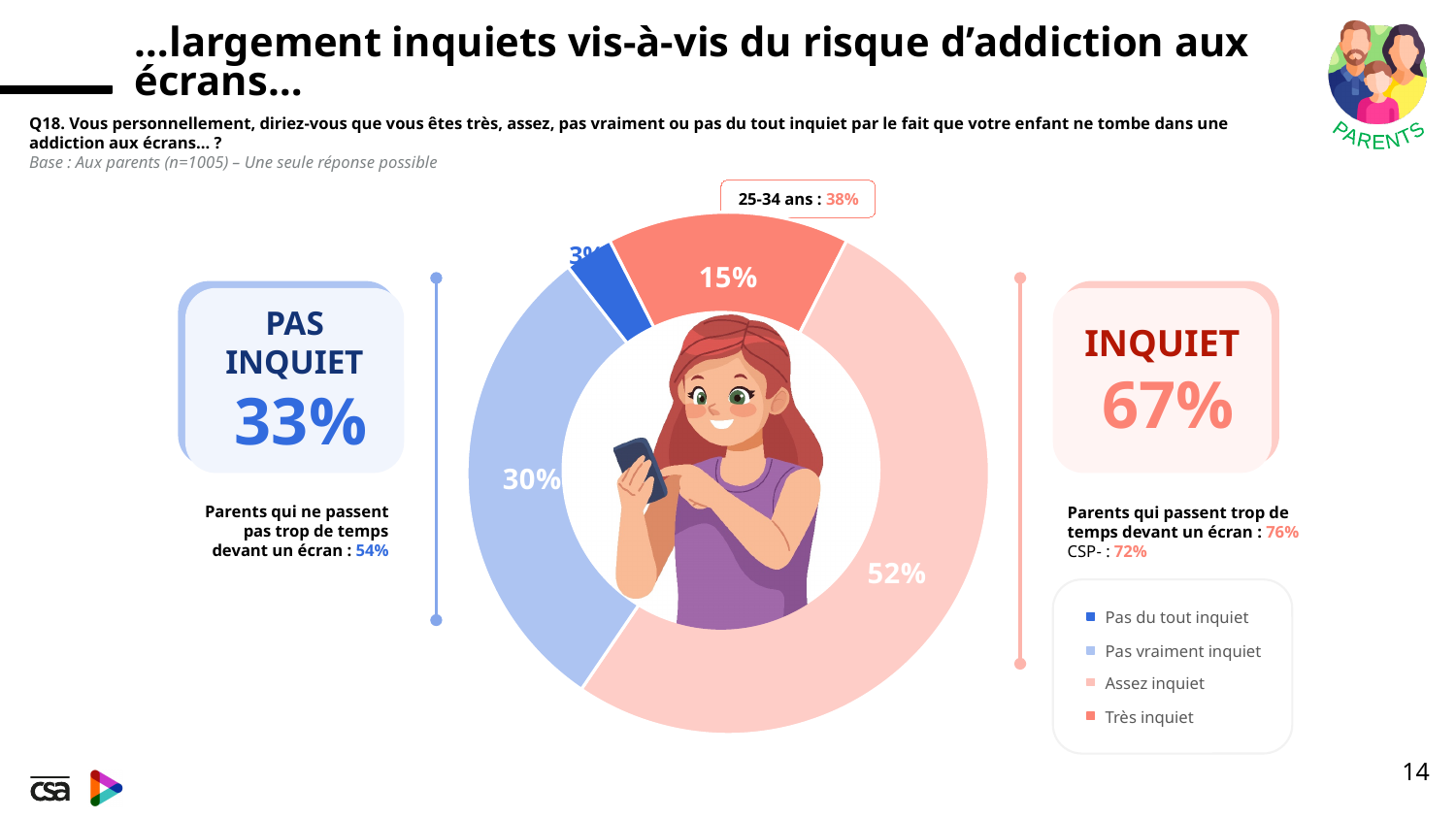
What is the combined share of parents who are "pas inquiet" (Pas du tout inquiet plus Pas vraiment inquiet)? 33% What kind of chart is shown on the slide? Pie (donut) chart Which response category has the largest share of the pie? Assez inquiet How many response categories does the legend list? 4 What percentage of parents answered "Très inquiet"? 15% What colour is used for the "Pas du tout inquiet" slice? Dark blue What is the combined share of parents who are "inquiet" (Assez inquiet plus Très inquiet)? 67% Which is larger: the share for "Très inquiet" or the share for "Pas vraiment inquiet"? Pas vraiment inquiet What is the difference between the "Assez inquiet" share and the "Pas vraiment inquiet" share? 22 percentage points What percentage of parents answered "Assez inquiet"? 52% Which response category has the smallest share of the pie? Pas du tout inquiet What percentage of parents answered "Pas vraiment inquiet"? 30%